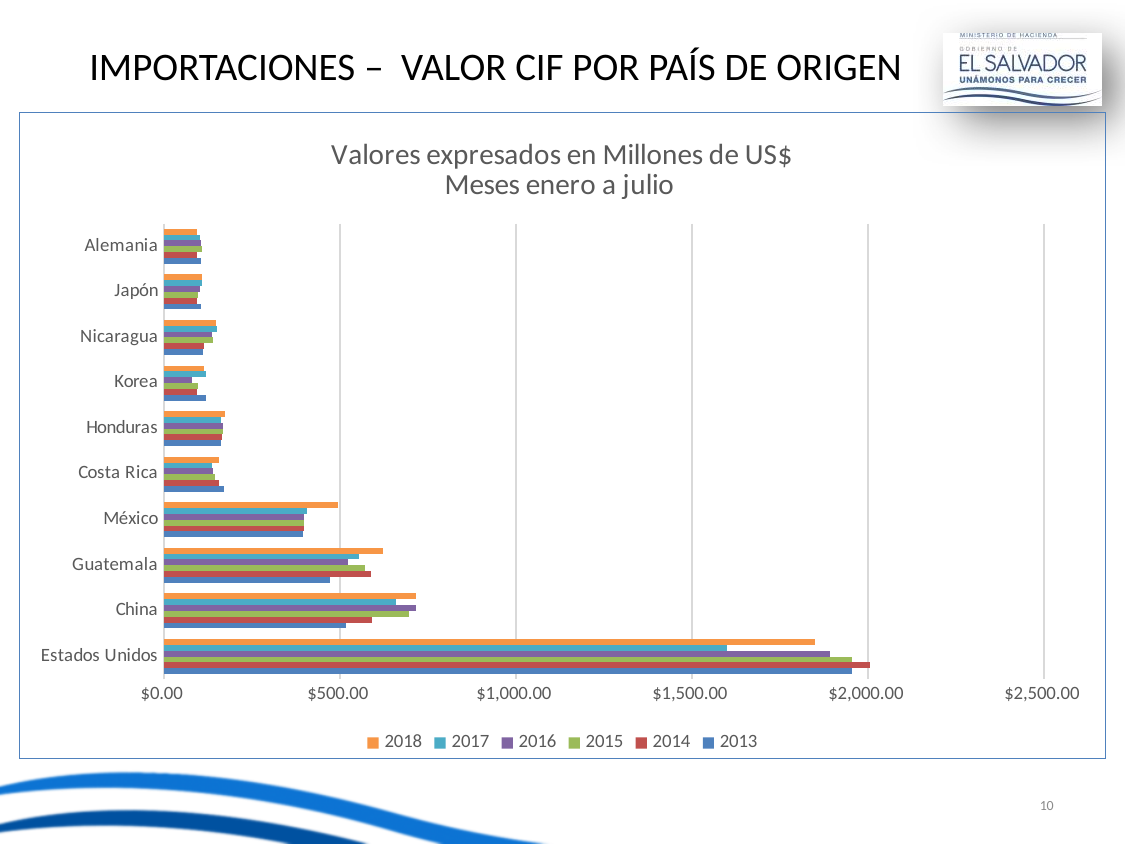
Which country has the highest import value in the chart? Estados Unidos Is the 2018 value for Estados Unidos greater or less than $1,500.00? greater What kind of chart is shown on the slide? bar chart How many countries are listed on the vertical axis of the chart? 10 Which is larger for 2018: the value for China or the value for Guatemala? China What is the first line of the chart title? Valores expresados en Millones de US$ Is the 2017 value for Estados Unidos greater or less than $2,000.00? less Is the 2018 value for China greater or less than $500.00? greater How many series does the legend list? 6 Which year is shown in orange in the legend? 2018 For Estados Unidos, which year has the larger value: 2017 or 2018? 2018